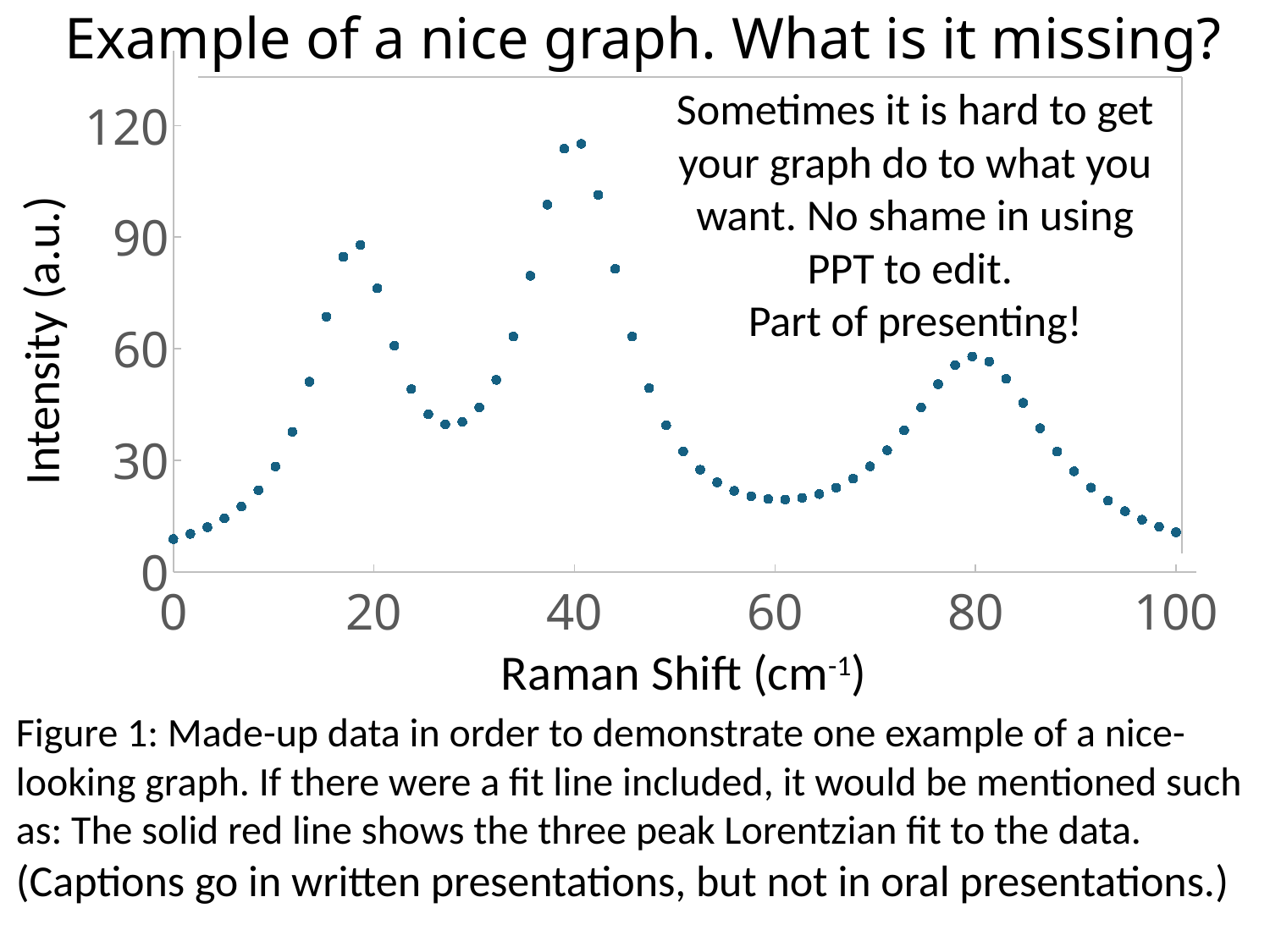
Is the intensity at a Raman shift of 40 greater or less than 90? greater Is the intensity at a Raman shift of 60 greater or less than 30? less What is the title of the x axis of the chart? Raman Shift (cm-1) Is the intensity at a Raman shift of 20 greater or less than 60? greater What is the title of the y axis of the chart? Intensity (a.u.) Near which x-axis tick value does the highest intensity point occur? 40 Which peak is higher: the one near a Raman shift of 20 or the one near 80? The one near 20 What kind of chart is shown on the slide? Scatter plot Which is larger: the intensity at a Raman shift of 40 or at 20? 40